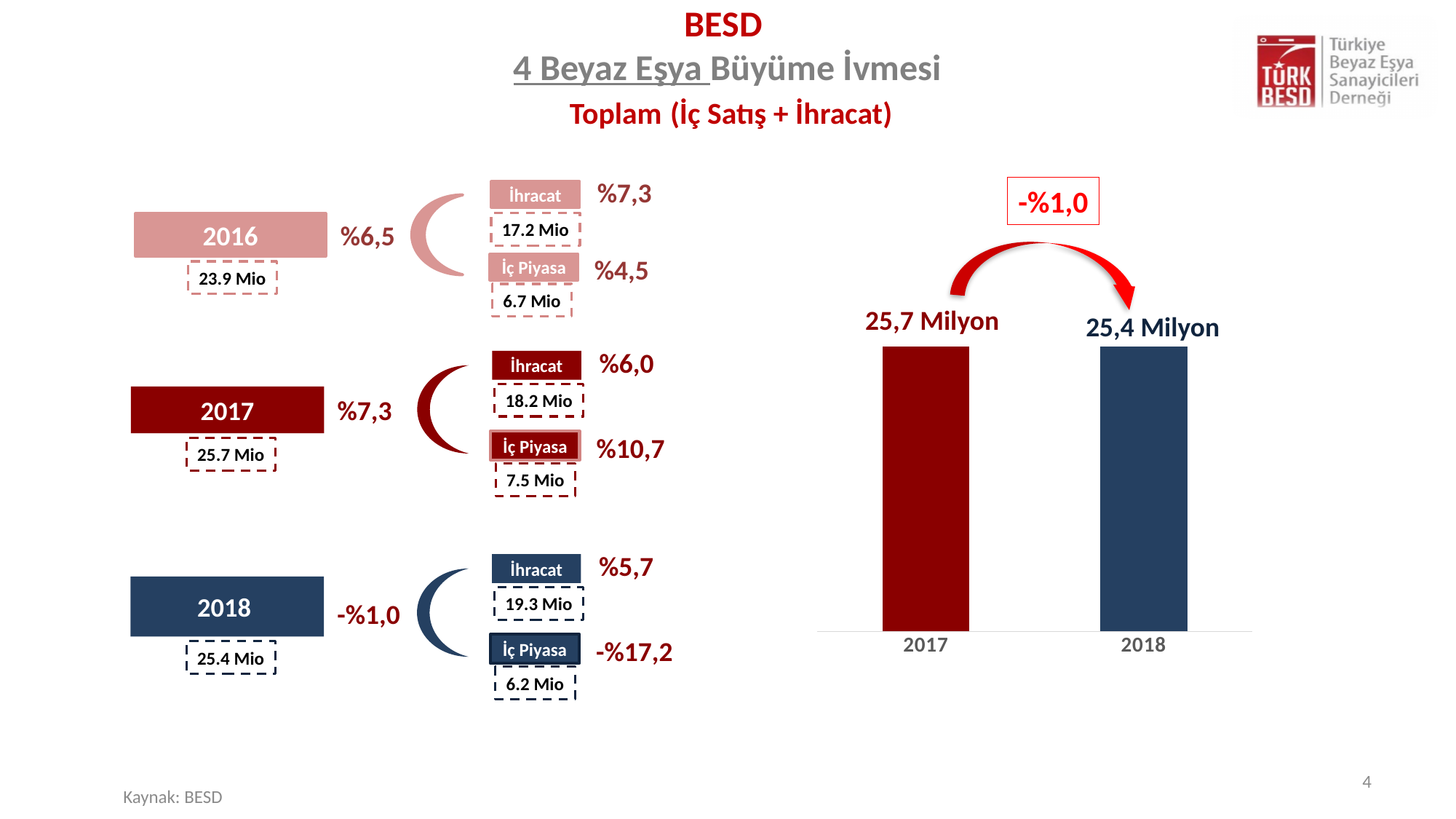
In the bar chart on the right, which year has the lower value? 2018 In the bar chart on the right, what is the value for 2018? 25,4 Milyon In the diagram on the left, what growth percentage is shown for İç Piyasa in 2017? %10,7 What type of chart is shown on the right side of the slide? bar chart In the bar chart on the right, which year has the higher value? 2017 In the bar chart on the right, do the values rise or fall from 2017 to 2018? fall In the bar chart on the right, is the value for 2017 larger or smaller than the value for 2018? larger What percentage change is shown above the arrow in the bar chart on the right? -%1,0 In the diagram on the left, what is the İhracat value shown for 2018? 19.3 Mio In the bar chart on the right, what is the difference between the 2017 and 2018 values? 0,3 Milyon How many bars are shown in the bar chart on the right? 2 In the bar chart on the right, what is the value for 2017? 25,7 Milyon